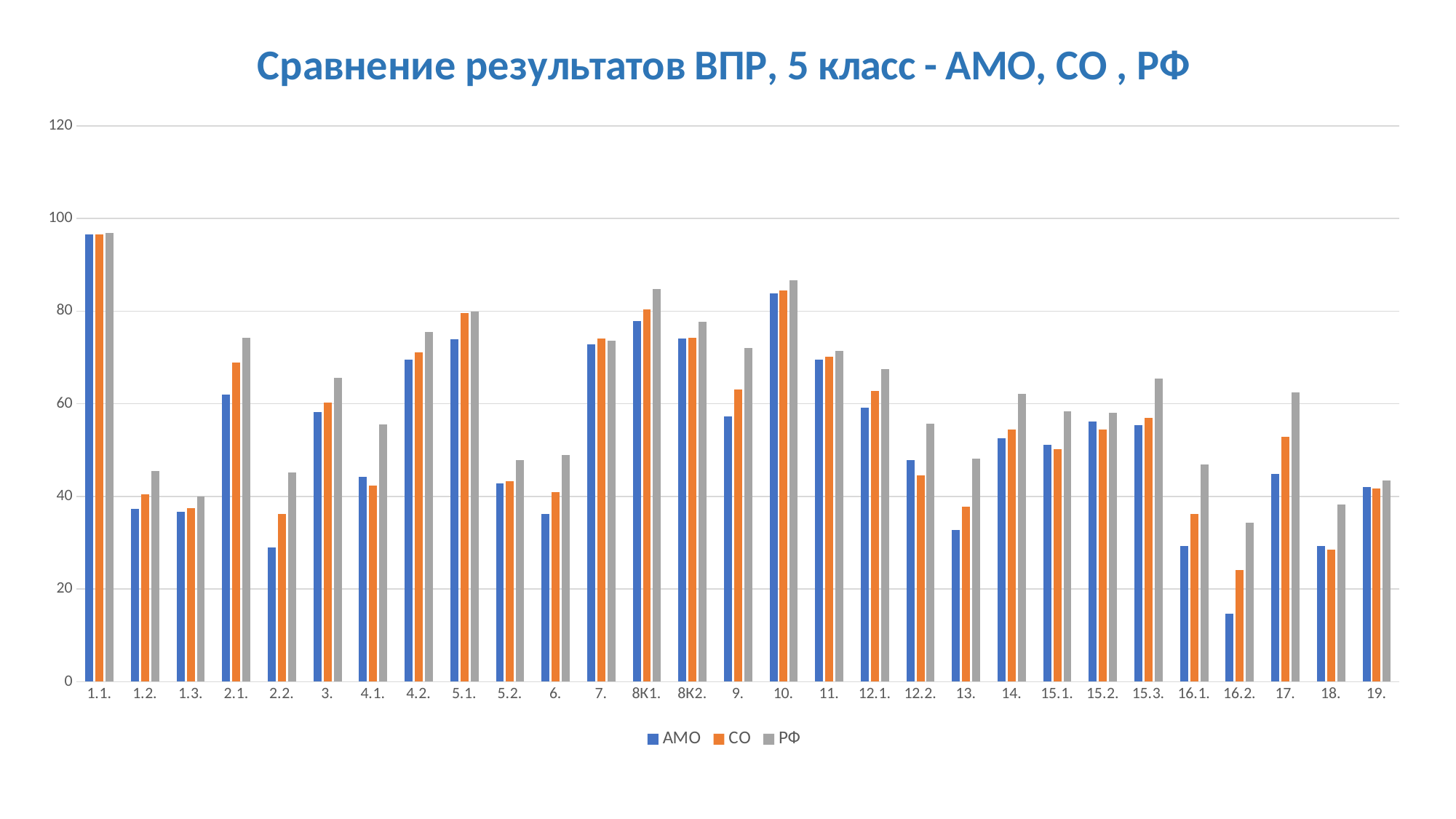
Is the value for АМО at category 16.2. greater or less than 20? less What kind of chart is shown on the slide? bar chart Is the value for РФ at category 10. greater or less than 80? greater What is the title of the chart? Сравнение результатов ВПР, 5 класс - АМО, СО , РФ Which category has the lowest value for the РФ series? 16.2. At category 16.1., which series has the larger value, АМО or СО? СО Which category has the lowest value for the АМО series? 16.2. How many categories are shown along the x axis? 29 Is the value for АМО at category 2.2. greater or less than 40? less How many series does the legend list? 3 At category 17., which series has the larger value, АМО or РФ? РФ Which category has the highest value for the АМО series? 1.1.